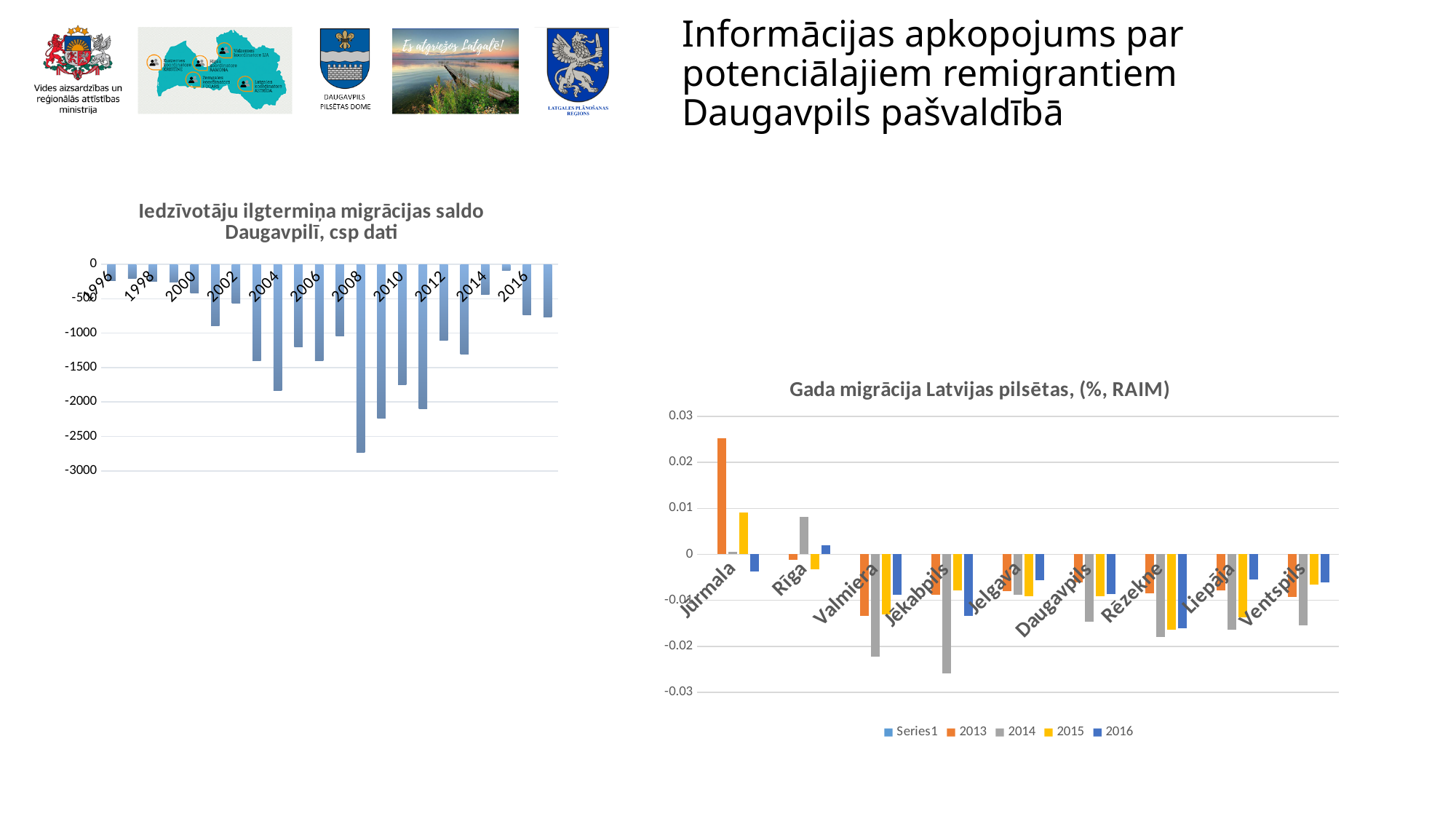
In the left chart (Iedzīvotāju ilgtermiņa migrācijas saldo Daugavpilī), is the value for 1996 greater or less than -500? greater In the right chart (Gada migrācija Latvijas pilsētas), is the 2014 value for Jēkabpils greater or less than -0.02? less How many cities are shown on the x axis of the right chart (Gada migrācija Latvijas pilsētas)? 9 In the right chart (Gada migrācija Latvijas pilsētas), is the 2013 value for Jūrmala greater or less than 0.02? greater In the left chart (Iedzīvotāju ilgtermiņa migrācijas saldo Daugavpilī), which year has the lowest value? 2008 What kind of chart is the left chart titled 'Iedzīvotāju ilgtermiņa migrācijas saldo Daugavpilī, csp dati'? bar chart What is the title of the right chart? Gada migrācija Latvijas pilsētas, (%, RAIM) In the left chart (Iedzīvotāju ilgtermiņa migrācijas saldo Daugavpilī), which is lower, the value for 2008 or the value for 2010? 2008 How many series does the legend of the right chart (Gada migrācija Latvijas pilsētas) list? 5 In the right chart (Gada migrācija Latvijas pilsētas), which city has the highest 2013 value? Jūrmala